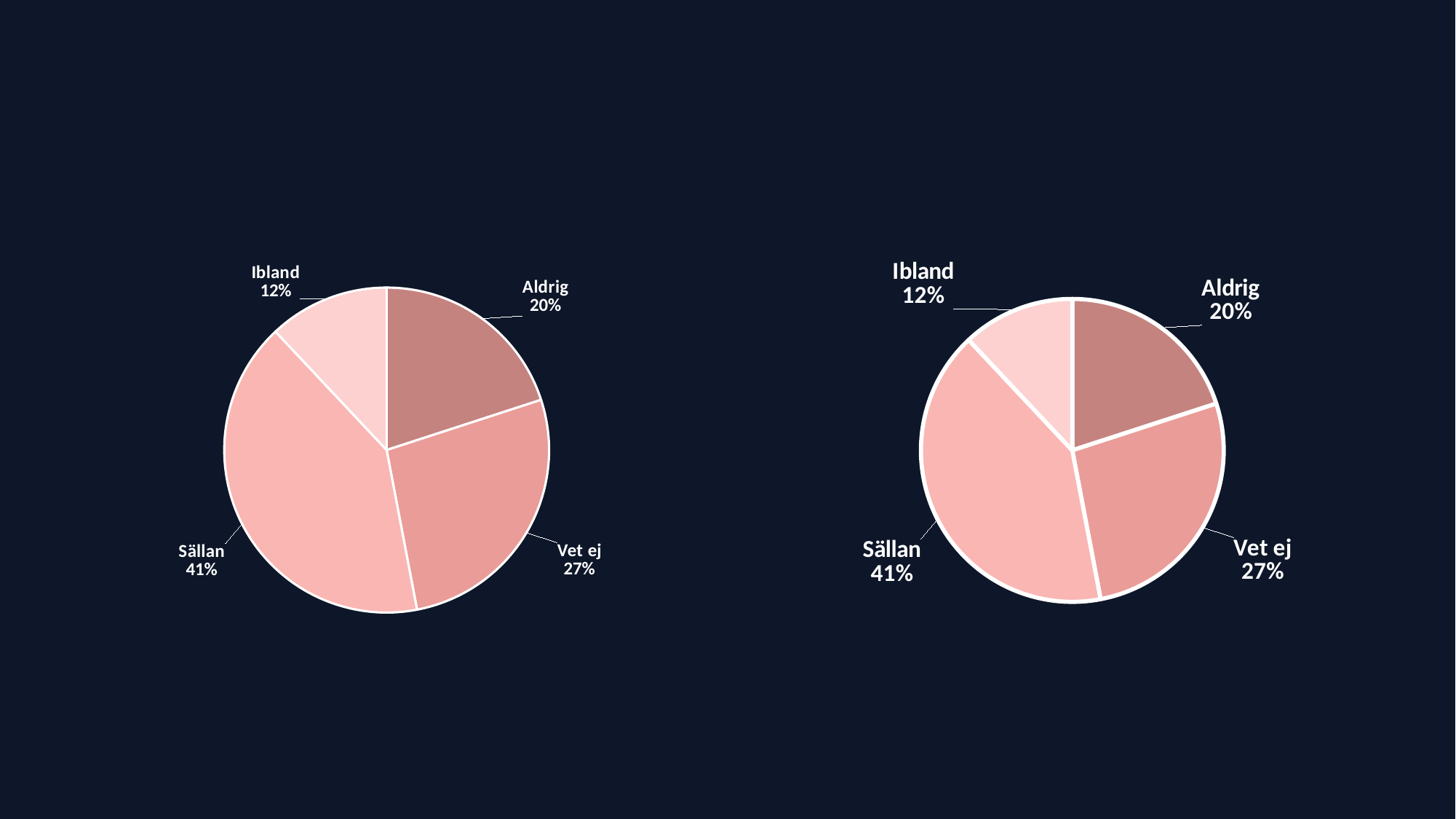
How many slices does the left pie chart have? 4 What kind of chart is the right chart? Pie chart In the left pie chart, what is the difference between Sällan and Vet ej? 14% In the right pie chart, which is larger, Aldrig or Vet ej? Vet ej In the right pie chart, which category has the smallest share? Ibland How many charts are shown on the slide? 2 In the right pie chart, what is the value for Ibland? 12% In the left pie chart, which category has the largest share? Sällan In the right pie chart, what is the value for Aldrig? 20% In the right pie chart, what is the difference between Aldrig and Ibland? 8% In the left pie chart, what is the value for Vet ej? 27% In the left pie chart, what is the value for Sällan? 41%